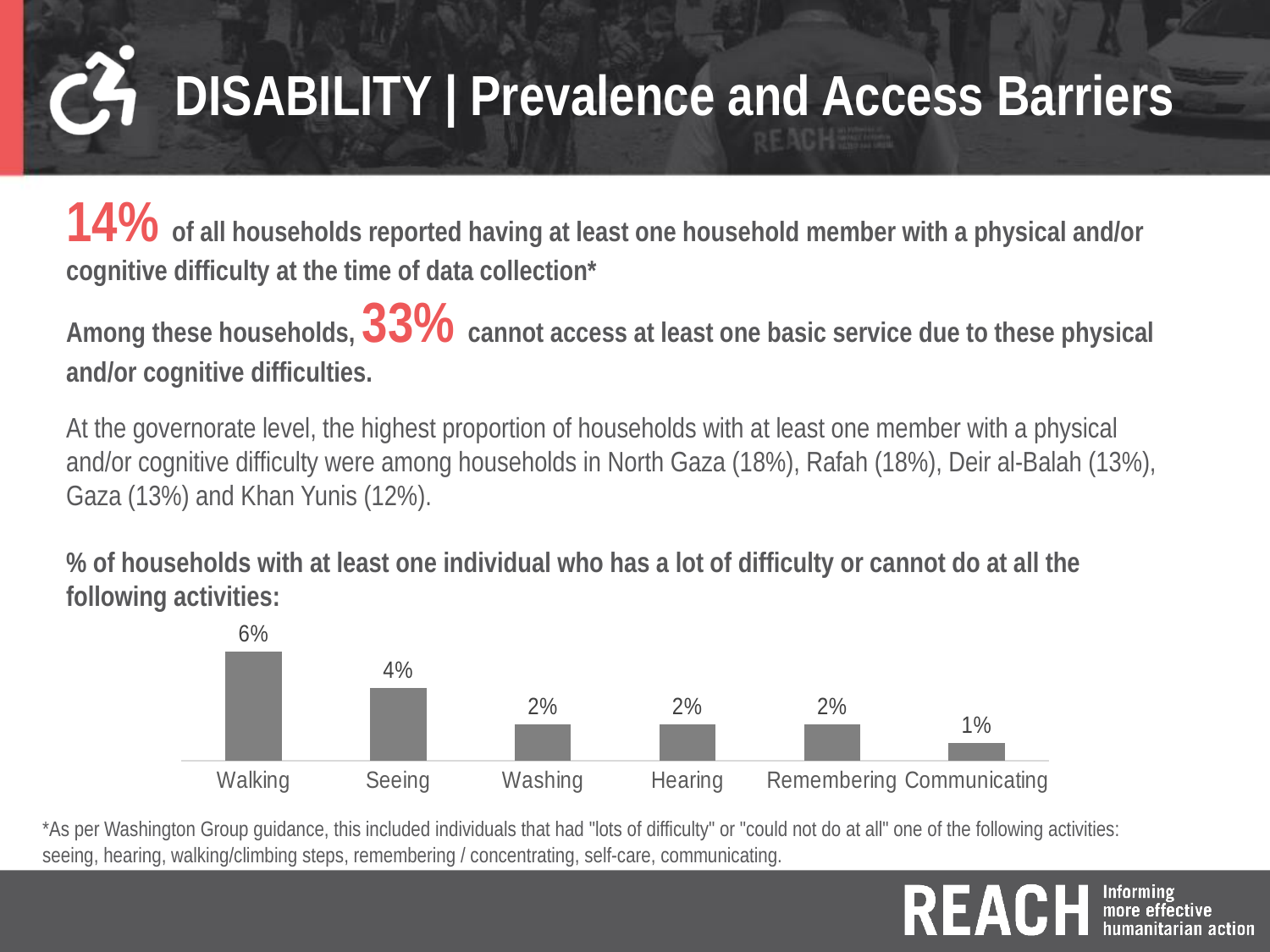
What is the difference between the percentages for Walking and Seeing? 2% Which has a higher percentage, Seeing or Washing? Seeing What type of chart is used to show the percentages by activity? Bar chart What percentage of households is shown for Hearing? 2% What percentage of households is shown for Communicating? 1% Do the values rise or fall from Walking to Communicating along the x axis? Fall What percentage of households is shown for Walking? 6% What percentage of households is shown for Seeing? 4% Which activity has the highest percentage of households? Walking Which activity has the lowest percentage of households? Communicating How many activities are shown in the chart? 6 What is the difference between the percentages for Seeing and Communicating? 3%